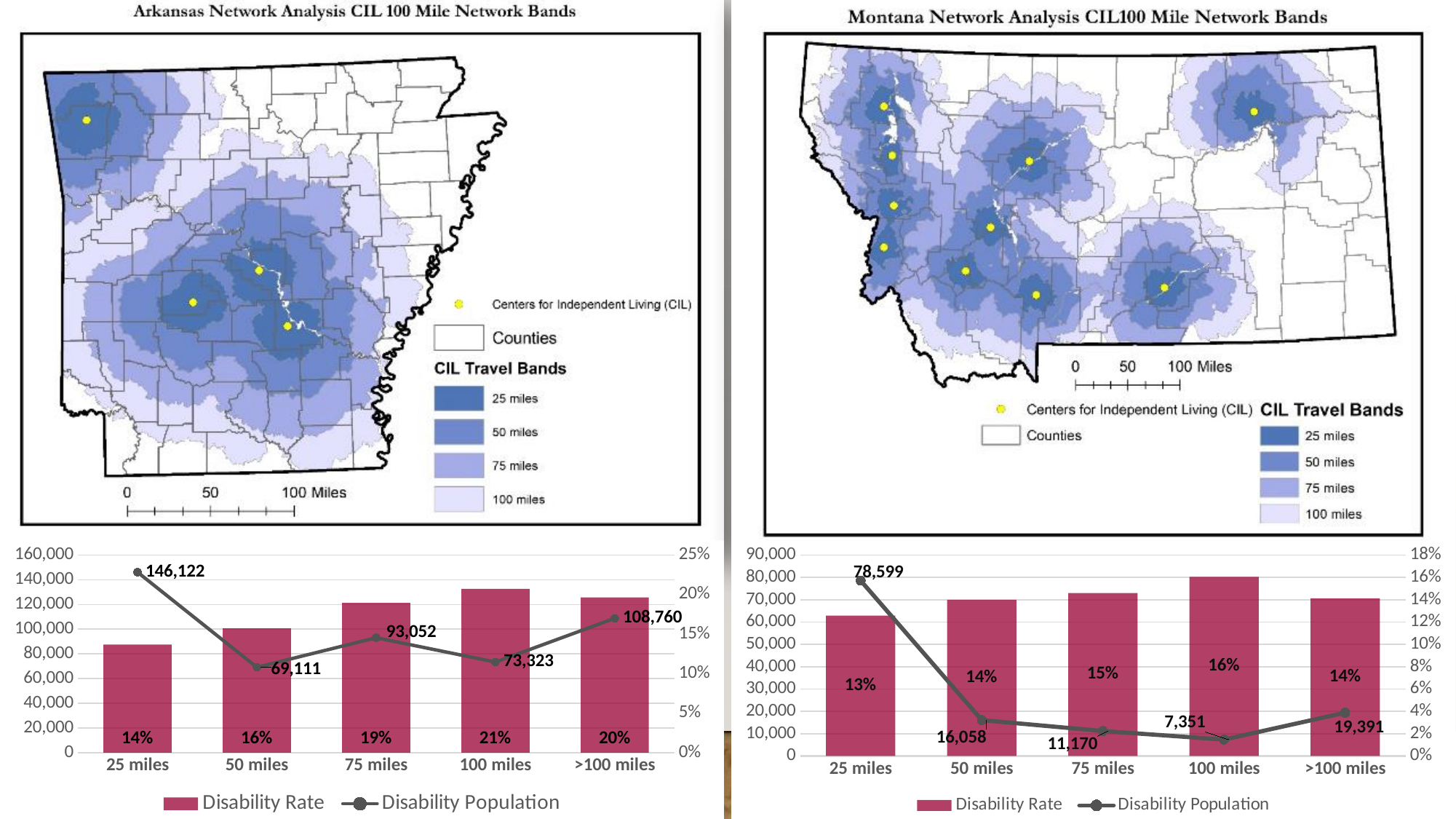
In the Montana chart (bottom right), what is the Disability Rate for the 100 miles band? 16% In the Montana chart (bottom right), how many percentage points higher is the Disability Rate at 100 miles than at 25 miles? 3 percentage points What kind of chart is the Arkansas chart (bottom left)? Combination bar and line chart How many travel band categories are shown on the x axis of the Arkansas chart (bottom left)? 5 In the Arkansas chart (bottom left), what is the difference between the Disability Population at 25 miles and at 50 miles? 77,011 In the Arkansas chart (bottom left), which travel band has the highest Disability Rate? 100 miles In the Arkansas chart (bottom left), what is the Disability Population for the 25 miles band? 146,122 What are the two legend entries in the Arkansas chart (bottom left)? Disability Rate and Disability Population In the Montana chart (bottom right), which travel band has the lowest Disability Population? 100 miles In the Montana chart (bottom right), which has the larger Disability Population: the 50 miles band or the >100 miles band? >100 miles How many series does the legend of the Montana chart (bottom right) list? 2 In the Montana chart (bottom right), does the Disability Population rise or fall from 25 miles to 100 miles? Fall